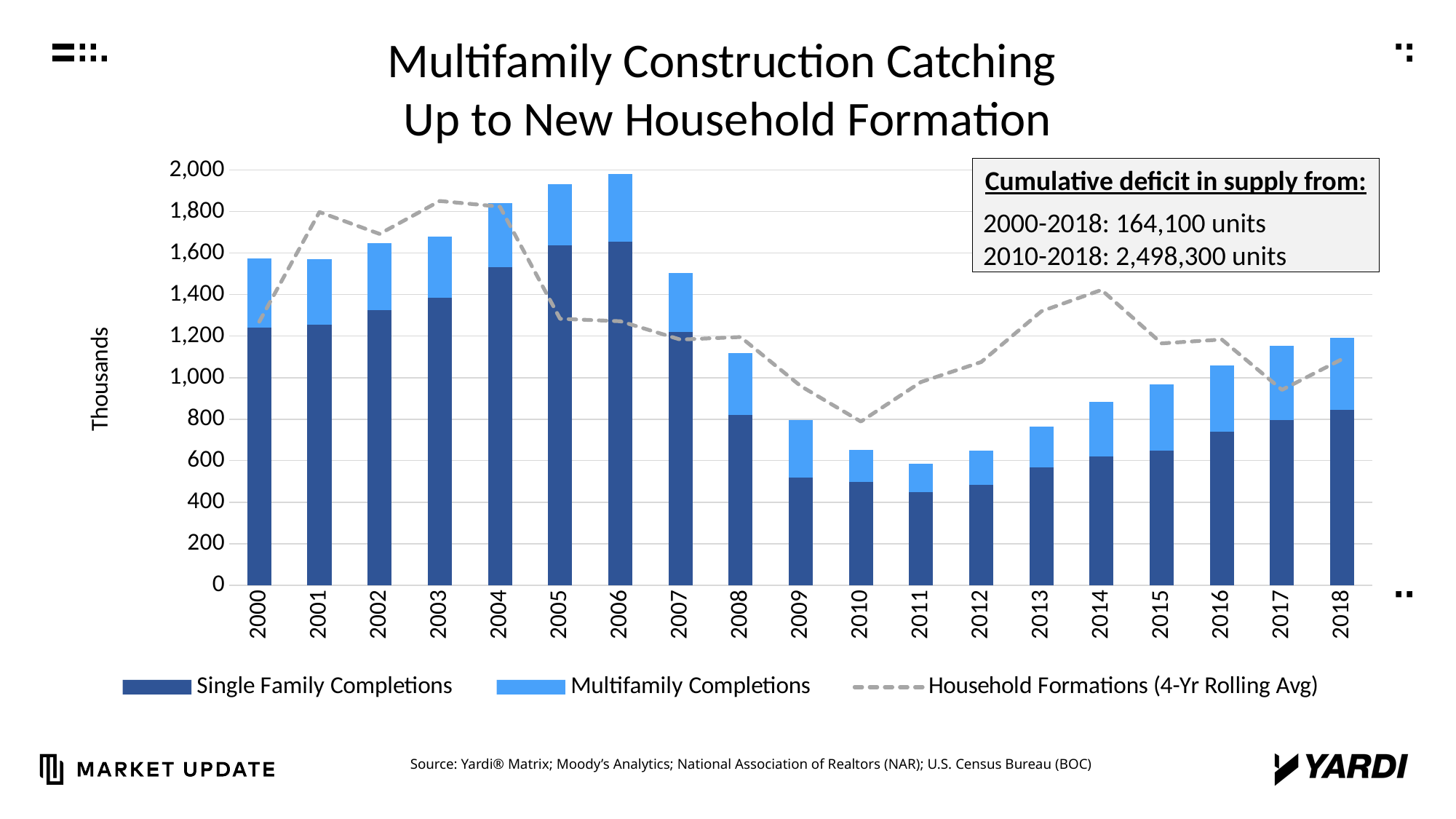
Is the total completions value for 2006 greater or less than 1,800? greater What kind of chart is shown on the slide? Stacked bar chart with a line Which year has the highest Single Family Completions? 2006 According to the text box on the chart, what is the cumulative deficit in supply from 2010-2018? 2,498,300 units Which year has the highest total completions (single family plus multifamily)? 2006 Is the total completions value for 2010 greater or less than 800? less Do total completions rise or fall from 2011 to 2018? rise How many years are shown on the x axis? 19 How many series does the legend list? 3 Which year has the lowest total completions? 2011 Is the Single Family Completions value for 2005 greater or less than 1,400? greater Which year has larger total completions, 2006 or 2007? 2006